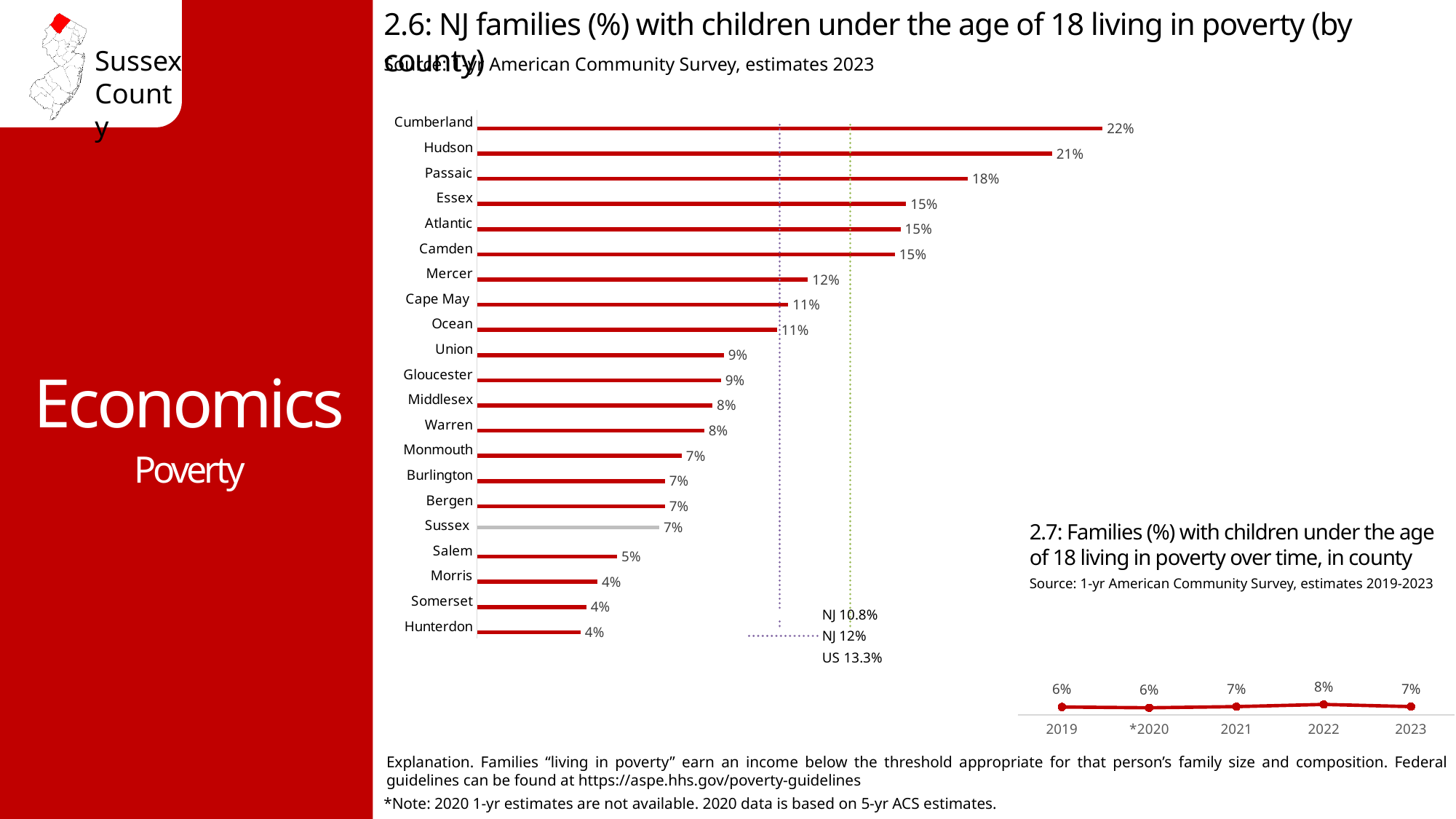
In chart 2.7 (families with children under 18 living in poverty over time, in county), what is the value for 2022? 8% In chart 2.6, what is the value for Hunterdon? 4% In chart 2.6, how many counties are plotted? 21 In chart 2.7, which year has the highest value? 2022 What kind of chart is chart 2.6? Bar chart In chart 2.6, what US value is marked by the reference line? 13.3% In chart 2.6, what is the value for Sussex? 7% In chart 2.6, which is larger, the value for Mercer or the value for Union? Mercer In chart 2.7, how many years are plotted? 5 In chart 2.6, which county has the highest percentage of families with children living in poverty? Cumberland In chart 2.6 (NJ families with children under 18 living in poverty by county), what is the value for Cumberland? 22% In chart 2.6, what is the difference between the values for Hudson and Passaic? 3%